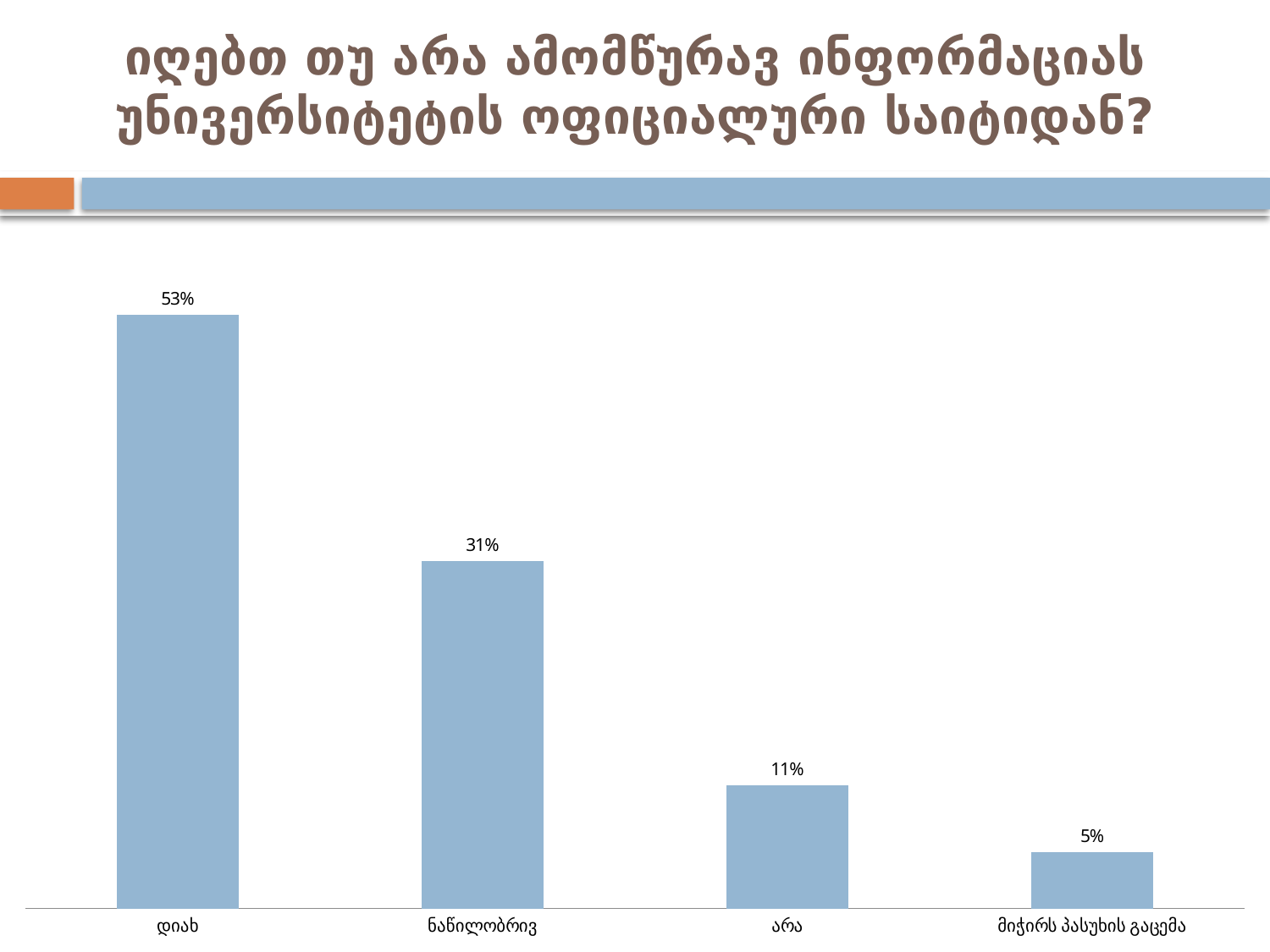
What kind of chart is shown on the slide? bar chart Do the values rise or fall from left to right along the x axis? fall How many categories are shown in the chart? 4 Which category has the highest value? დიახ Which category has the lowest value? მიჭირს პასუხის გაცემა Which is larger, the value for ნაწილობრივ or the value for არა? ნაწილობრივ What is the difference between the values for არა and მიჭირს პასუხის გაცემა? 6% What is the value for ნაწილობრივ? 31% What is the value for მიჭირს პასუხის გაცემა? 5% What is the difference between the values for დიახ and ნაწილობრივ? 22% What is the value for არა? 11% What is the value for დიახ? 53%